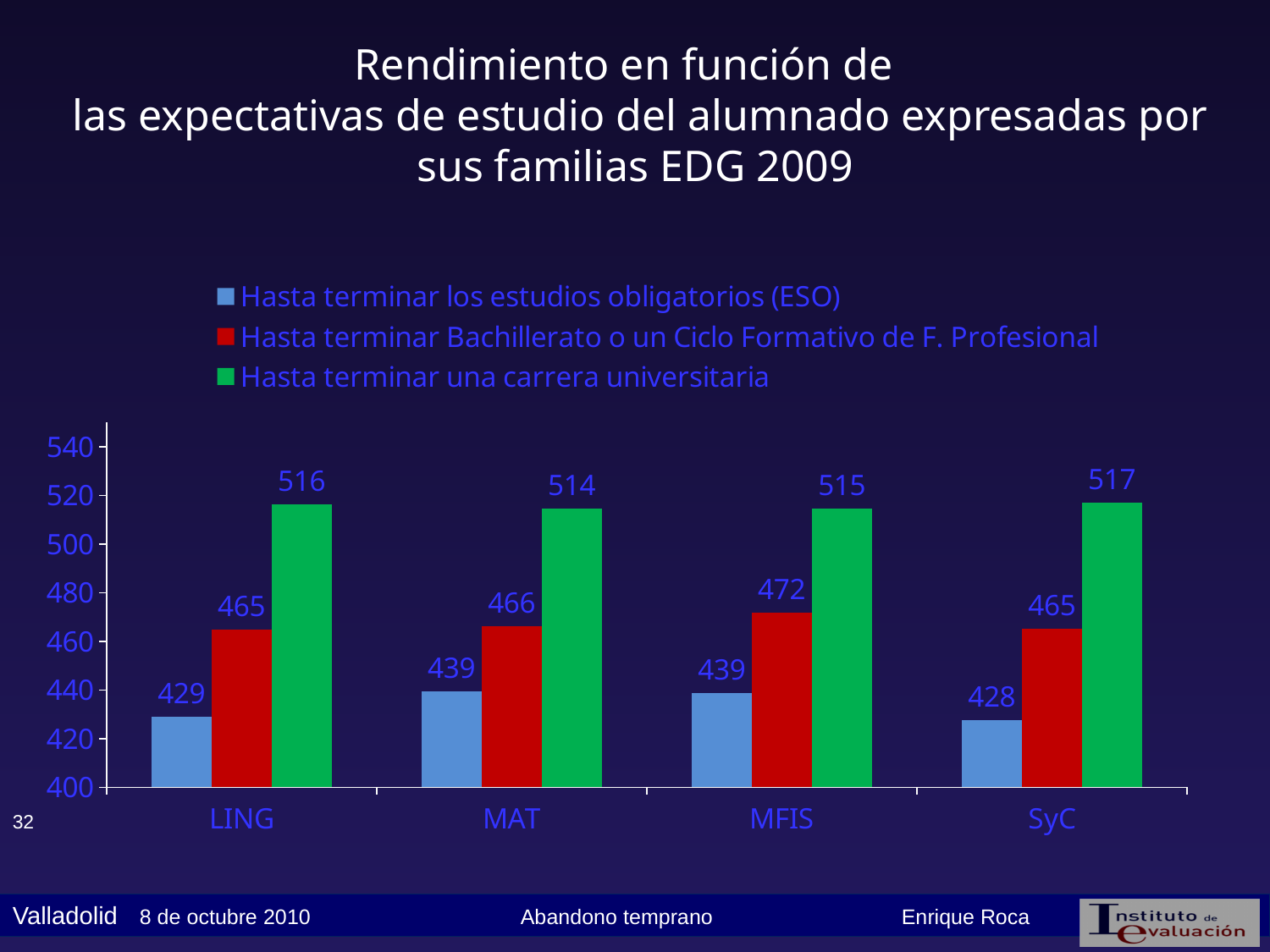
Which category has the highest value in the series 'Hasta terminar una carrera universitaria'? SyC How many categories are shown on the x axis? 4 Which is larger for MFIS: the 'Hasta terminar Bachillerato o un Ciclo Formativo de F. Profesional' value or the 'Hasta terminar los estudios obligatorios (ESO)' value? Hasta terminar Bachillerato o un Ciclo Formativo de F. Profesional What is the value for MFIS in the series 'Hasta terminar Bachillerato o un Ciclo Formativo de F. Profesional'? 472 What is the difference between the 'Hasta terminar una carrera universitaria' value and the 'Hasta terminar los estudios obligatorios (ESO)' value for LING? 87 How many series does the legend list? 3 What kind of chart is shown on the slide? bar chart What is the value for SyC in the series 'Hasta terminar los estudios obligatorios (ESO)'? 428 Is the value for MAT in the series 'Hasta terminar Bachillerato o un Ciclo Formativo de F. Profesional' greater or less than 460? greater What colour represents the series 'Hasta terminar una carrera universitaria'? green What is the value for MAT in the series 'Hasta terminar una carrera universitaria'? 514 Which category has the lowest value in the series 'Hasta terminar los estudios obligatorios (ESO)'? SyC